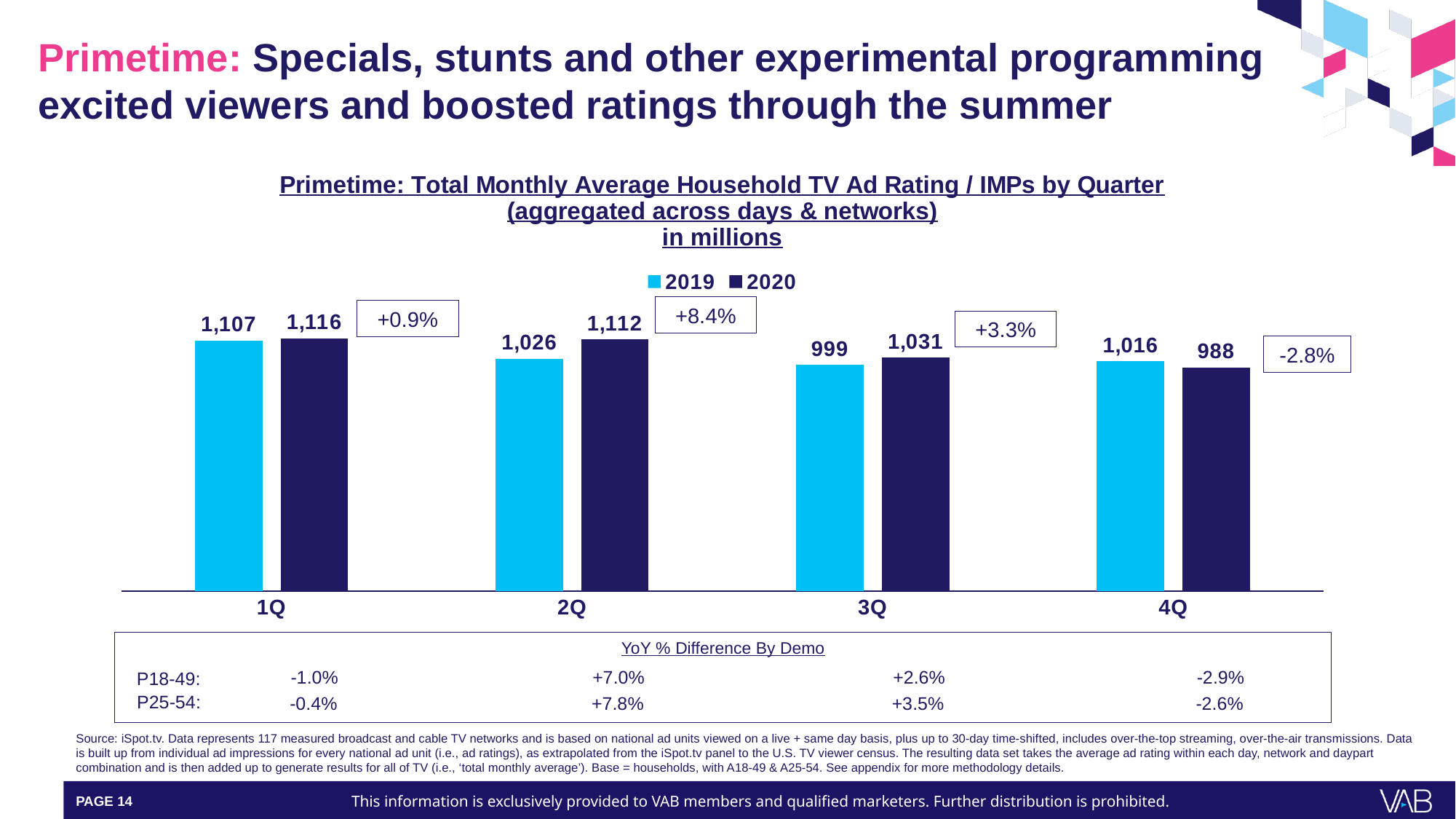
What kind of chart is shown? Bar chart What is the 2019 value for 1Q? 1,107 Which quarter has the highest 2020 value? 1Q How many quarters are shown on the x axis? 4 What is the 2020 value for 4Q? 988 How many series does the legend list? 2 Which quarter has the lowest 2019 value? 3Q What is the difference between the 2020 and 2019 values for 2Q? 86 Which is larger for 4Q, the 2019 value or the 2020 value? 2019 What year-over-year percentage change is shown for 3Q? +3.3% What is the 2019 value for 3Q? 999 What is the 2020 value for 2Q? 1,112